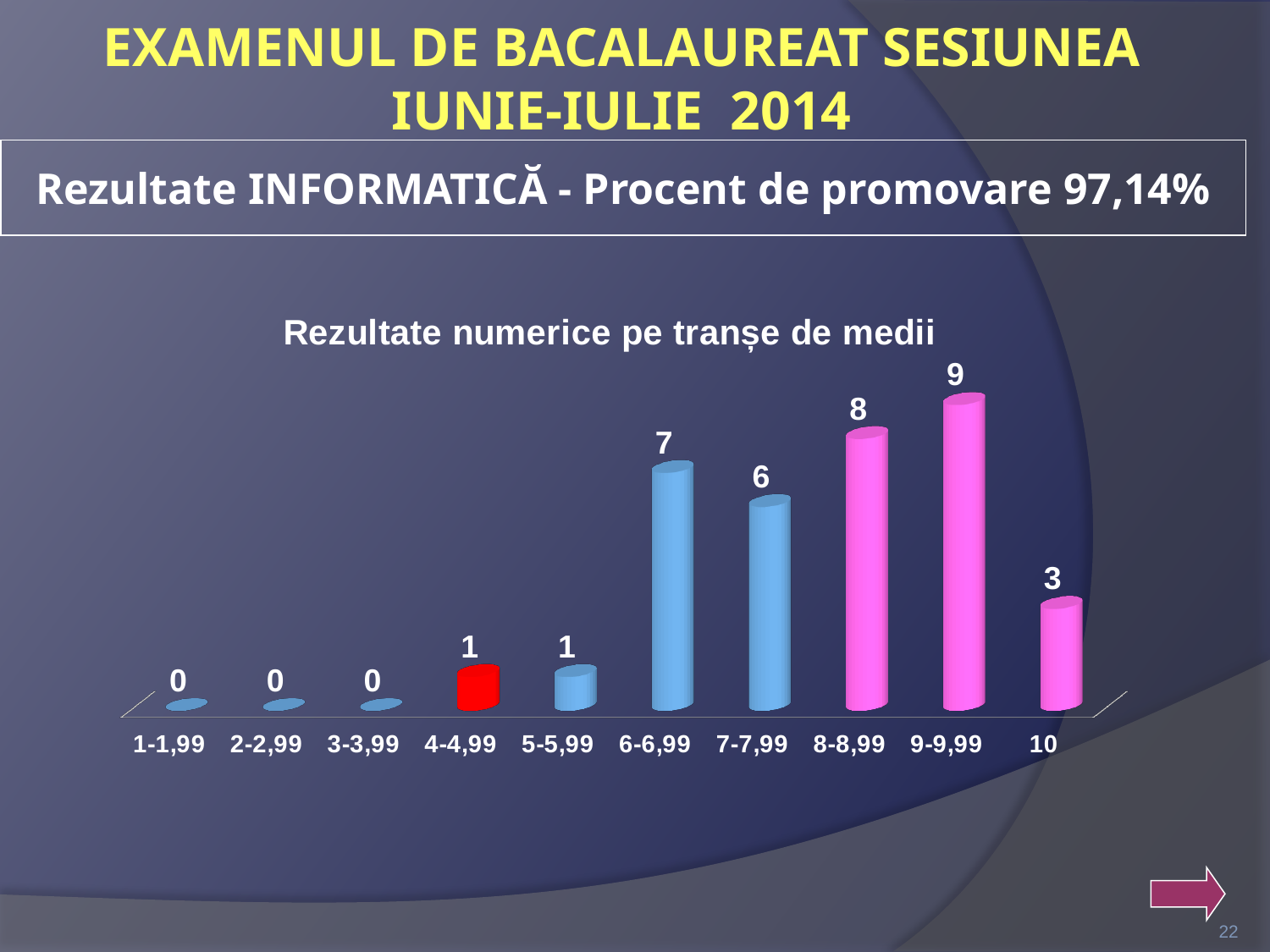
Which is larger, the value for 6-6,99 or the value for 7-7,99? 6-6,99 What is the title of the chart? Rezultate numerice pe tranșe de medii What is the value for the 9-9,99 category? 9 How many categories have a value of 0? 3 Which category's bar is coloured red? 4-4,99 Which category has the highest value? 9-9,99 How many categories are shown on the x axis? 10 What kind of chart is shown on the slide? Bar chart What is the value for the 6-6,99 category? 7 What is the total of the values for 8-8,99, 9-9,99 and 10? 20 What is the value for the 10 category? 3 What is the difference between the values for 8-8,99 and 7-7,99? 2